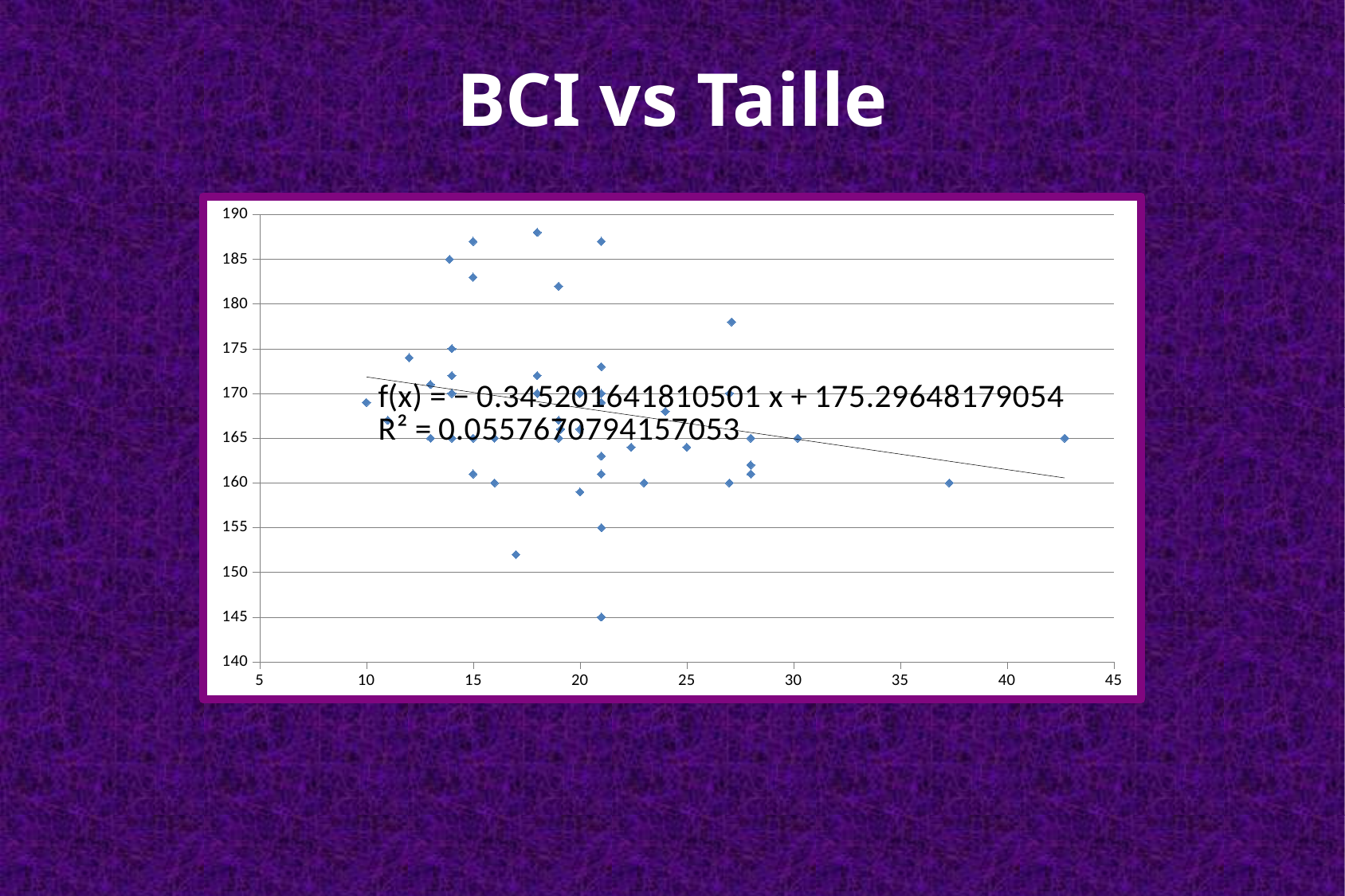
What is the slope of the fitted line f(x) shown on the chart? -0.345201641810501 Is the y value of the lowest point on the chart greater or less than 150? less What kind of chart is shown on the slide? scatter chart What R² value is printed on the chart? 0.0557670794157053 What is the maximum value shown on the y axis? 190 What is the intercept of the fitted line f(x) shown on the chart? 175.29648179054 Is the R² value printed on the chart greater or less than 0.5? less What is the title of the chart? BCI vs Taille Does the fitted trendline rise or fall as x increases? fall Is the x value of the rightmost point on the chart greater or less than 40? greater